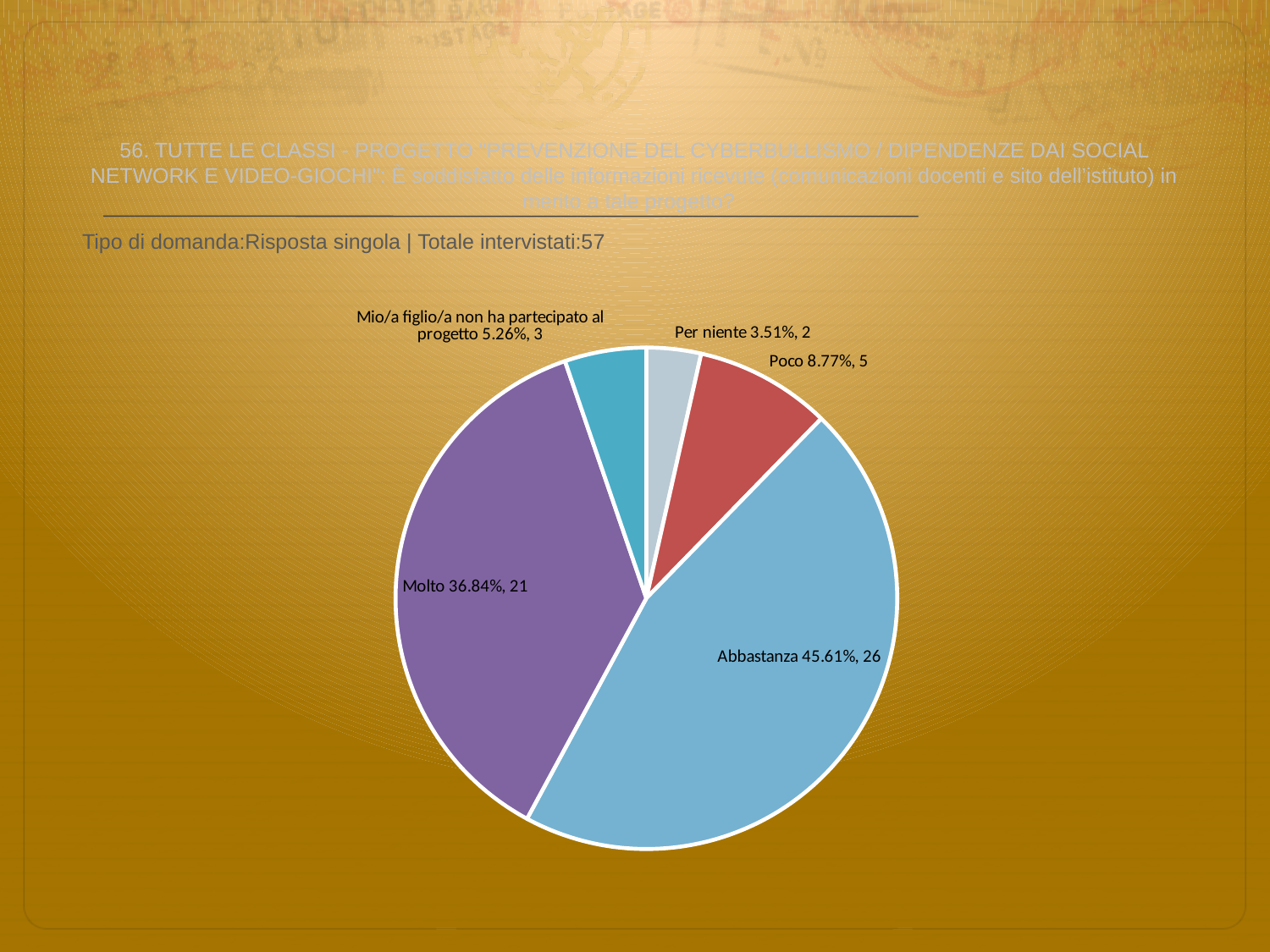
What is the difference in respondent count between "Abbastanza" and "Molto"? 5 Which category has the largest slice of the pie? Abbastanza How many respondents answered "Molto"? 21 What colour is the "Molto" slice? purple What percentage share does the "Abbastanza" slice have? 45.61% Which has more respondents, "Poco" or "Mio/a figlio/a non ha partecipato al progetto"? Poco How many slices does the pie chart have? 5 Which category has the smallest slice of the pie? Per niente What kind of chart is shown on the slide? pie chart What is the total number of respondents shown in the pie chart? 57 How many respondents answered "Per niente"? 2 What percentage share does the "Poco" slice have? 8.77%